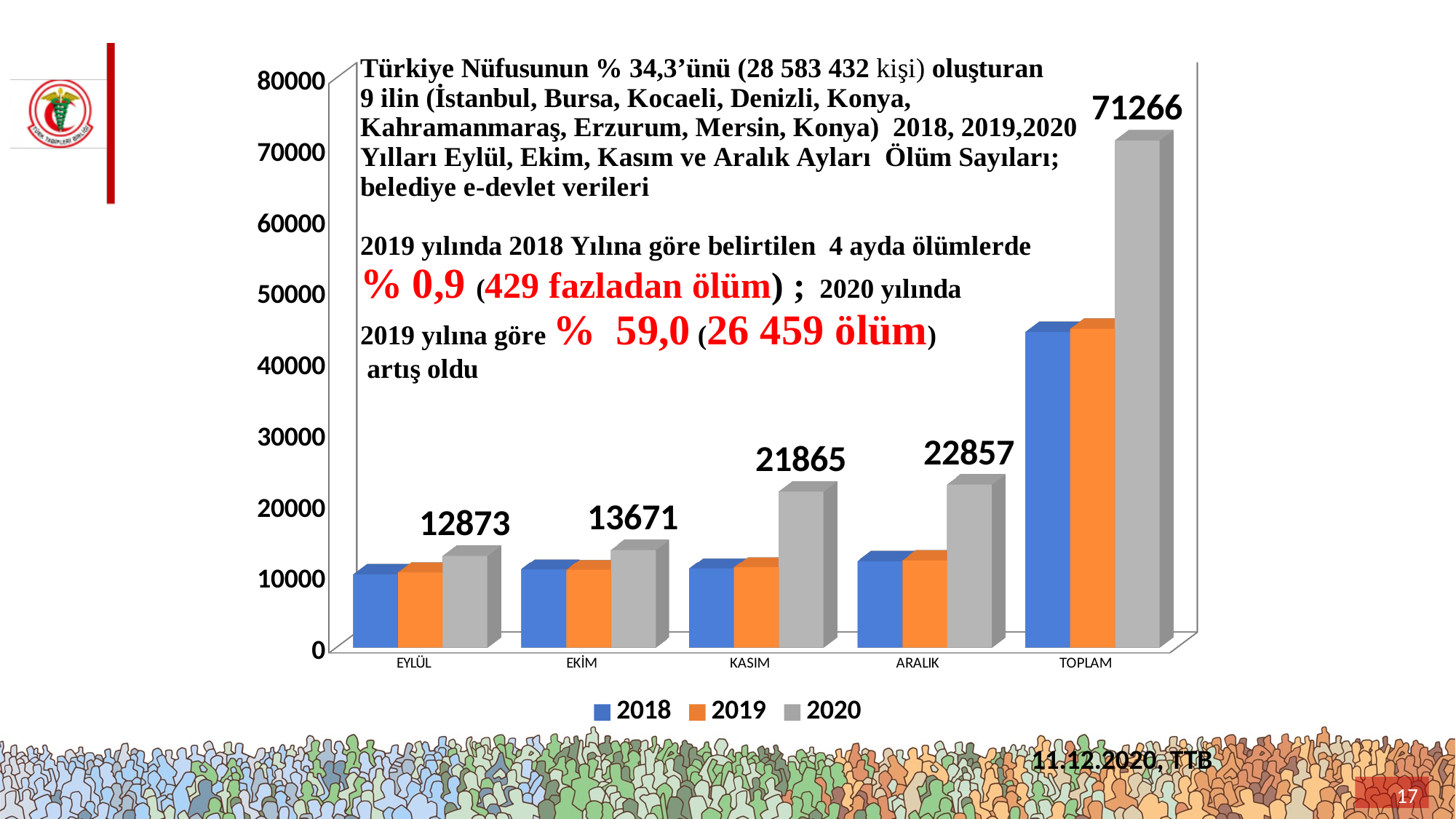
How many series does the legend list? 3 What is the difference between the 2020 values for KASIM and EKİM? 8194 Is the value for 2018 in EYLÜL greater or less than 20000? less What is the value for 2020 in TOPLAM? 71266 Among the four months (excluding TOPLAM), which has the highest 2020 value? ARALIK What is the value for 2020 in KASIM? 21865 How many categories are shown on the x axis? 5 What is the difference between the 2020 values for ARALIK and KASIM? 992 What is the value for 2020 in EYLÜL? 12873 Which is larger, the 2020 value for KASIM or the 2020 value for EKİM? KASIM Is the value for 2018 in TOPLAM greater or less than 40000? greater Among the four months (excluding TOPLAM), which has the lowest 2020 value? EYLÜL